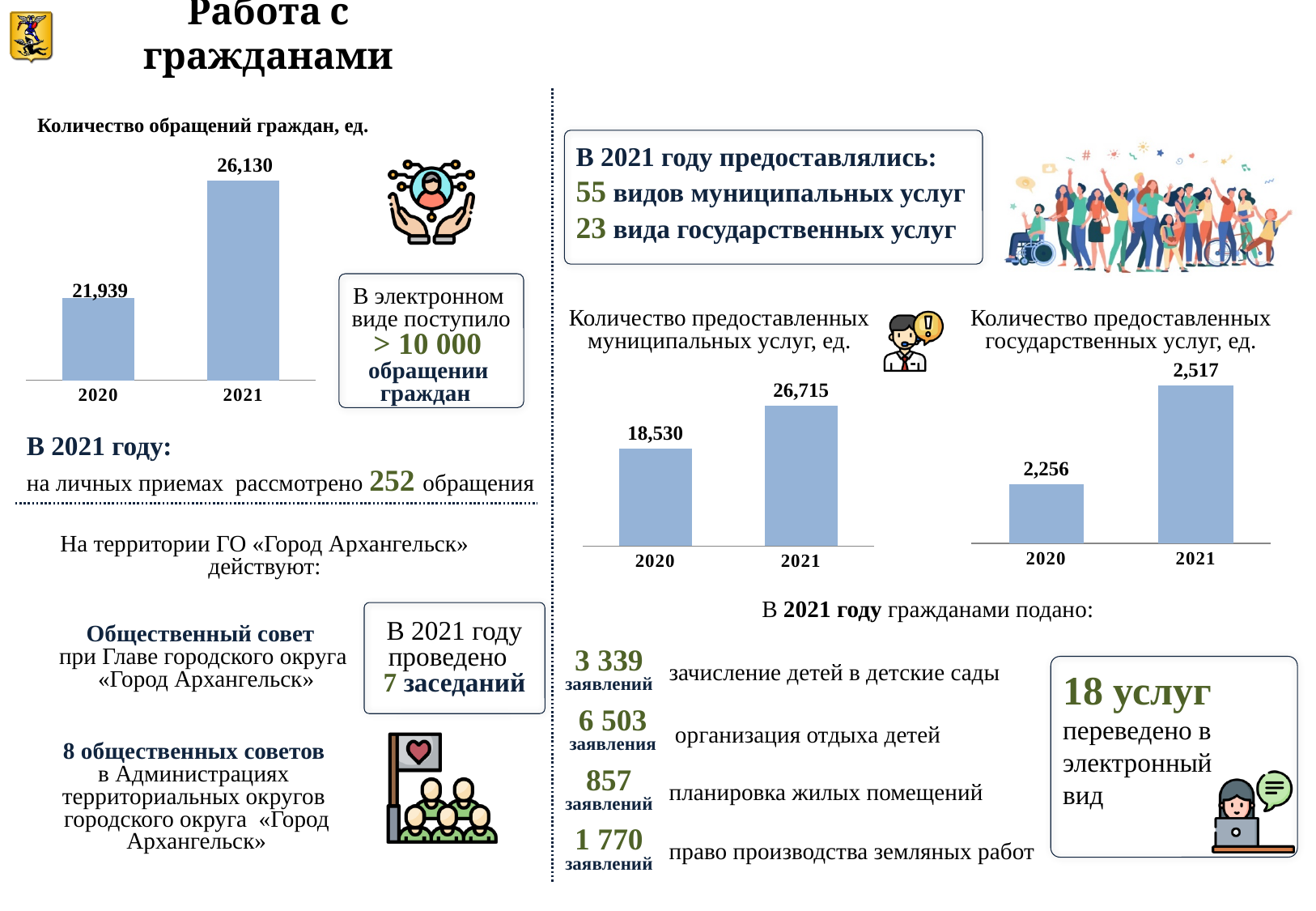
In the chart 'Количество обращений граждан, ед.', do the values rise or fall from 2020 to 2021? rise In the chart 'Количество обращений граждан, ед.', what is the value for 2021? 26,130 In the chart 'Количество предоставленных государственных услуг, ед.', what is the value for 2021? 2,517 In the chart 'Количество предоставленных государственных услуг, ед.', which year has the lowest value? 2020 In the chart 'Количество обращений граждан, ед.', what is the difference between the 2021 and 2020 values? 4,191 In the chart 'Количество предоставленных муниципальных услуг, ед.', what is the value for 2020? 18,530 In the chart 'Количество предоставленных муниципальных услуг, ед.', what is the difference between the 2021 and 2020 values? 8,185 What kind of chart is 'Количество предоставленных государственных услуг, ед.'? bar chart In the chart 'Количество предоставленных муниципальных услуг, ед.', which year has the highest value? 2021 In the chart 'Количество обращений граждан, ед.', what is the value for 2020? 21,939 In the chart 'Количество предоставленных государственных услуг, ед.', what is the value for 2020? 2,256 In the chart 'Количество предоставленных муниципальных услуг, ед.', what is the value for 2021? 26,715